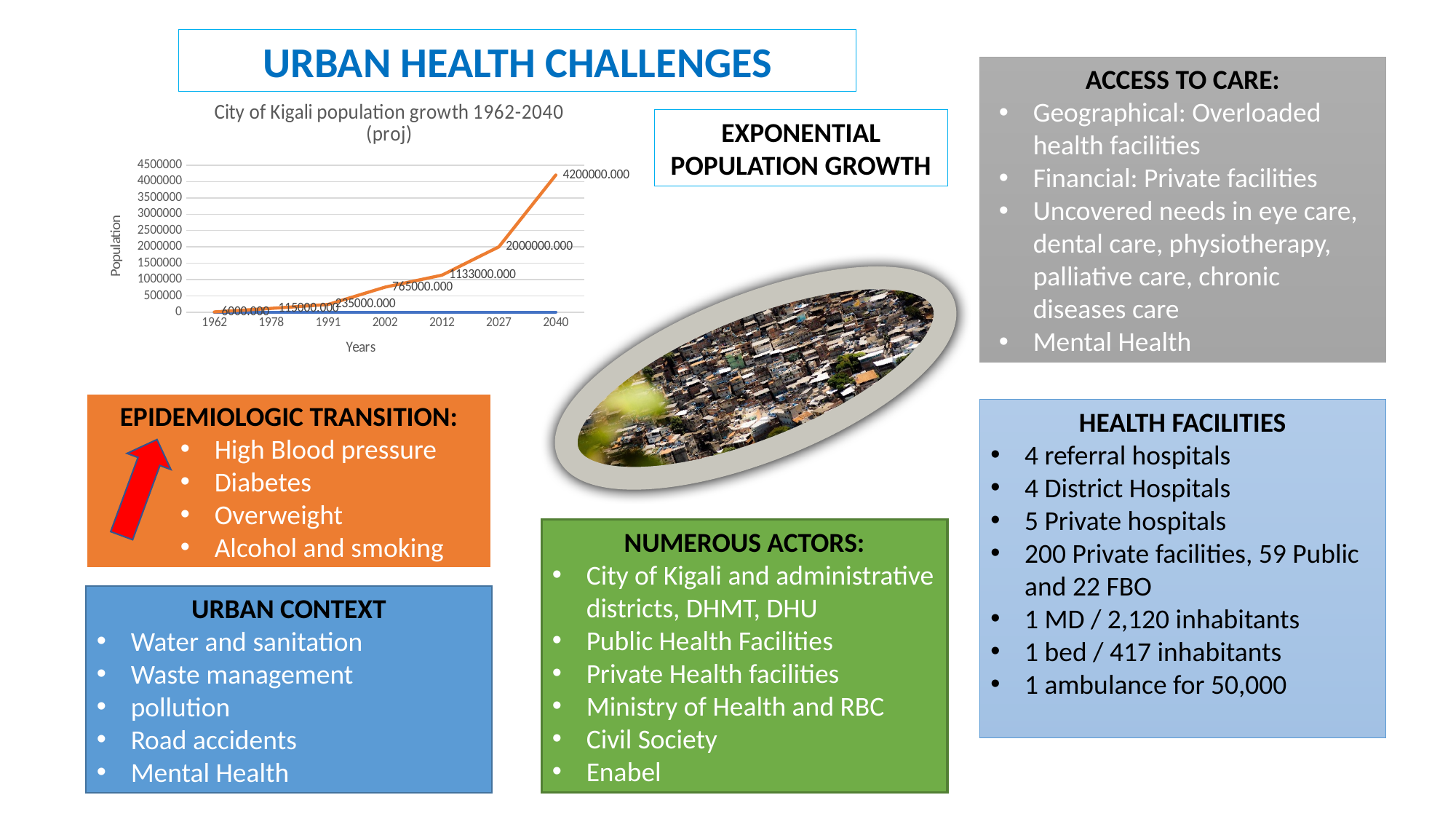
What is the population value labelled for 2002 in the City of Kigali population growth chart? 765000.000 How many years are shown on the x axis of the City of Kigali population growth chart? 7 What is the title of the chart on the slide? City of Kigali population growth 1962-2040 (proj) Which year has the lowest population value in the City of Kigali population growth chart? 1962 What is the population value labelled for 2040 in the City of Kigali population growth chart? 4200000.000 What is the difference between the population values for 2040 and 2027 in the City of Kigali population growth chart? 2200000.000 What type of chart is used to show the City of Kigali population growth? line chart What is the population value labelled for 2012 in the City of Kigali population growth chart? 1133000.000 Does the population in the City of Kigali population growth chart rise or fall from 1962 to 2040? rise What is the population value labelled for 1962 in the City of Kigali population growth chart? 6000.000 Which is larger in the City of Kigali population growth chart, the value for 1991 or the value for 1978? 1991 Which year has the highest population value in the City of Kigali population growth chart? 2040